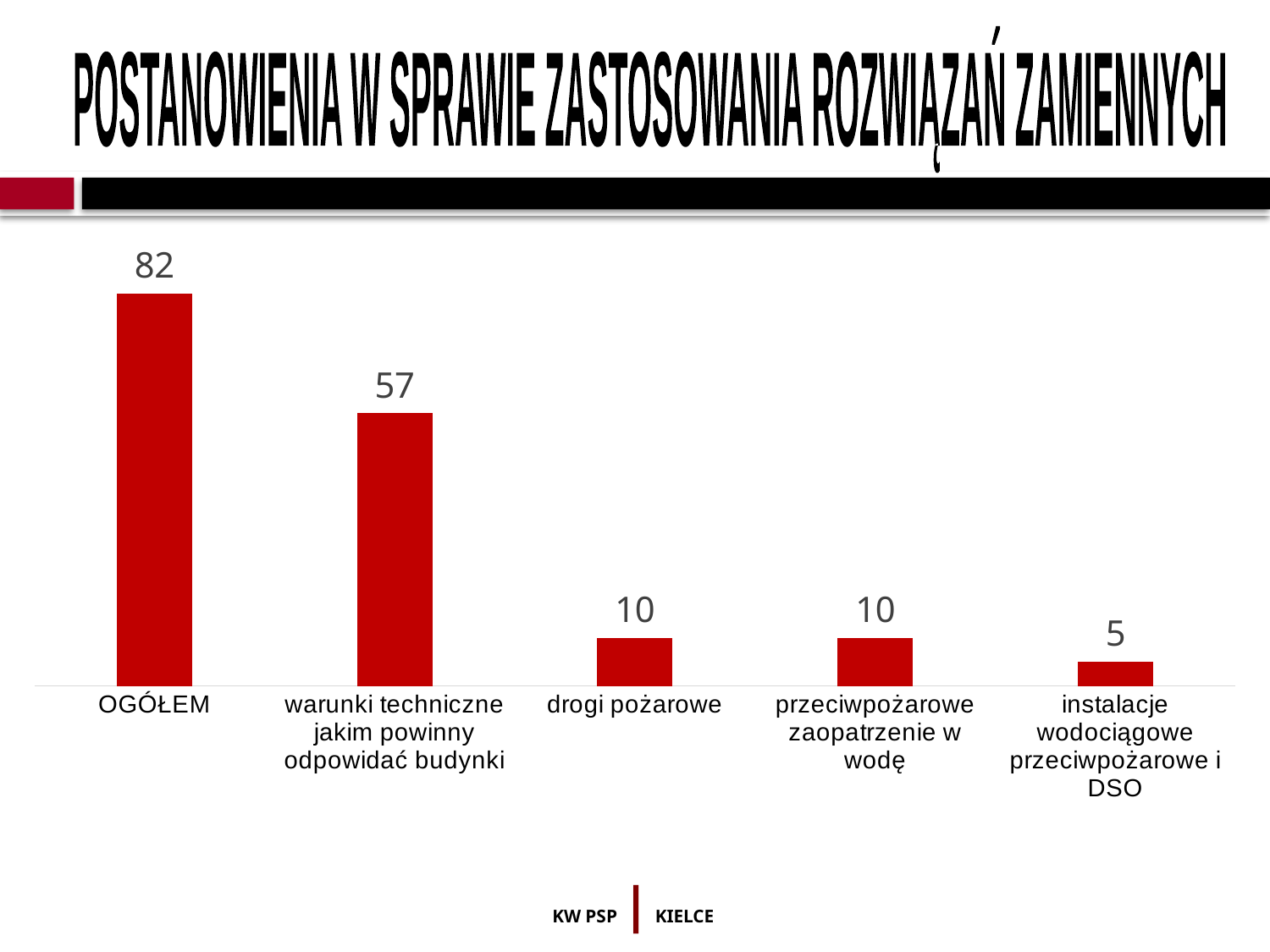
What is the difference between the values for OGÓŁEM and 'warunki techniczne jakim powinny odpowiadać budynki'? 25 How many categories are shown in the chart? 5 What is the value for 'warunki techniczne jakim powinny odpowiadać budynki'? 57 Which category has the highest value? OGÓŁEM Which category has the lowest value? instalacje wodociągowe przeciwpożarowe i DSO What is the difference between the values for 'drogi pożarowe' and 'instalacje wodociągowe przeciwpożarowe i DSO'? 5 What kind of chart is shown on the slide? bar chart What colour are the bars in the chart? red Which is larger: the value for 'warunki techniczne jakim powinny odpowiadać budynki' or the value for 'przeciwpożarowe zaopatrzenie w wodę'? warunki techniczne jakim powinny odpowiadać budynki What is the value for 'instalacje wodociągowe przeciwpożarowe i DSO'? 5 What is the value for OGÓŁEM? 82 What is the value for 'drogi pożarowe'? 10